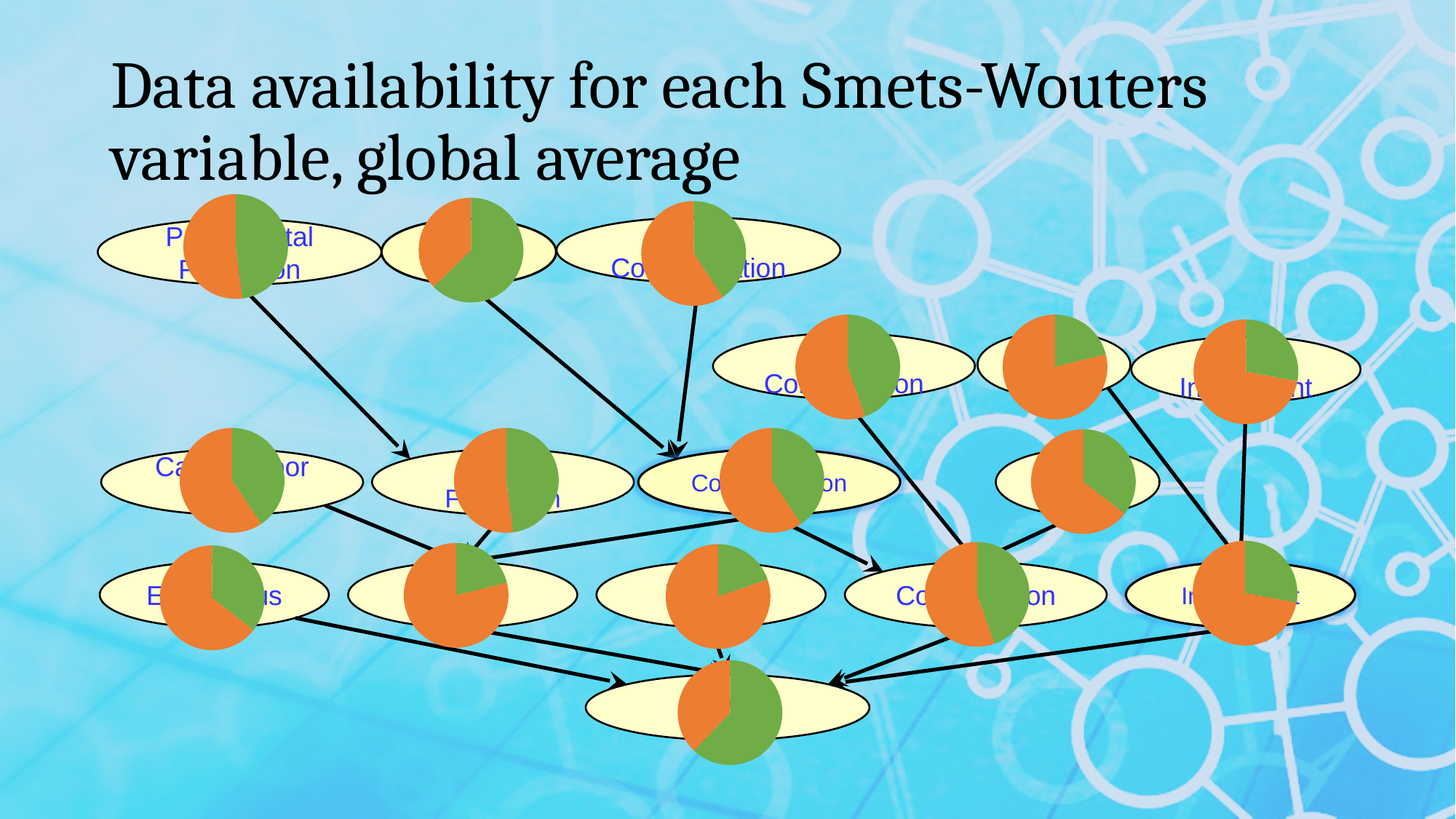
In the top-middle pie chart of the top row, which colour has the larger share, orange or green? green In the pie chart over the 'Exogenous' label at the left of the bottom row, which colour has the larger share, orange or green? orange How many slices does each pie chart on the slide have? 2 Which two colours are used for the slices in the pie charts? orange and green What kind of chart is used to show data availability for each variable on this slide? pie chart In the pie chart over the 'Investment' label in the upper right of the diagram, which colour has the larger share, orange or green? orange How many small pie charts are shown on the slide? 16 What is the title of the slide containing the pie charts? Data availability for each Smets-Wouters variable, global average